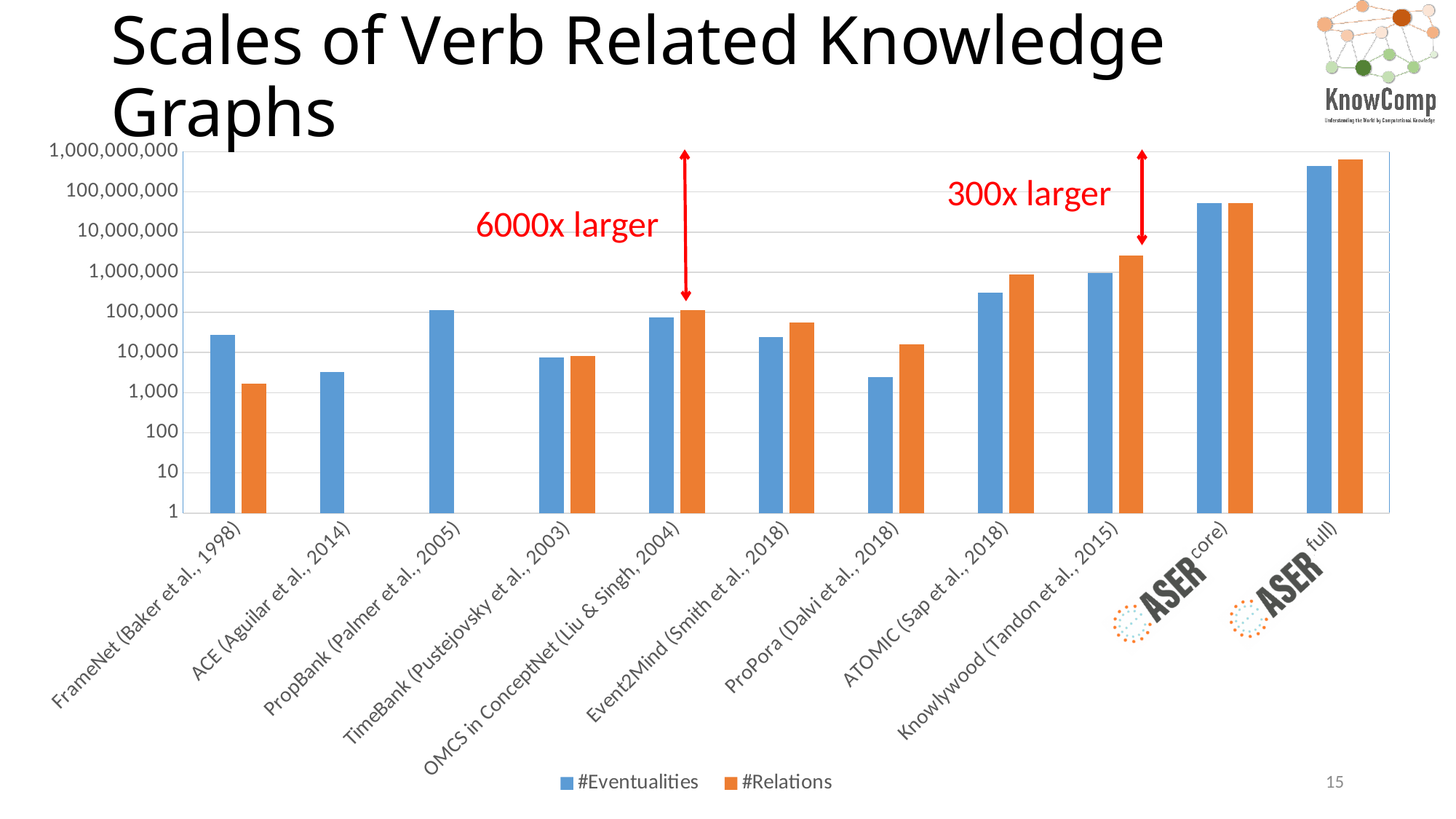
Which has more #Relations: ATOMIC (Sap et al., 2018) or Knowlywood (Tandon et al., 2015)? Knowlywood (Tandon et al., 2015) Which knowledge graph has the highest #Relations value? ASER (full) What kind of chart is shown on the slide? bar chart Is the #Eventualities value for ACE (Aguilar et al., 2014) greater or less than 10,000? less How many knowledge graphs (categories) are shown on the x axis? 11 Which is larger for FrameNet (Baker et al., 1998): #Eventualities or #Relations? #Eventualities Is the #Relations value for ASER (full) greater or less than 100,000,000? greater How many series does the legend list? 2 Is the #Eventualities value for FrameNet (Baker et al., 1998) greater or less than 10,000? greater Which knowledge graph has the lowest #Relations value among those with a #Relations bar? FrameNet (Baker et al., 1998) What does the red annotation between OMCS in ConceptNet and the top of the chart say? 6000x larger